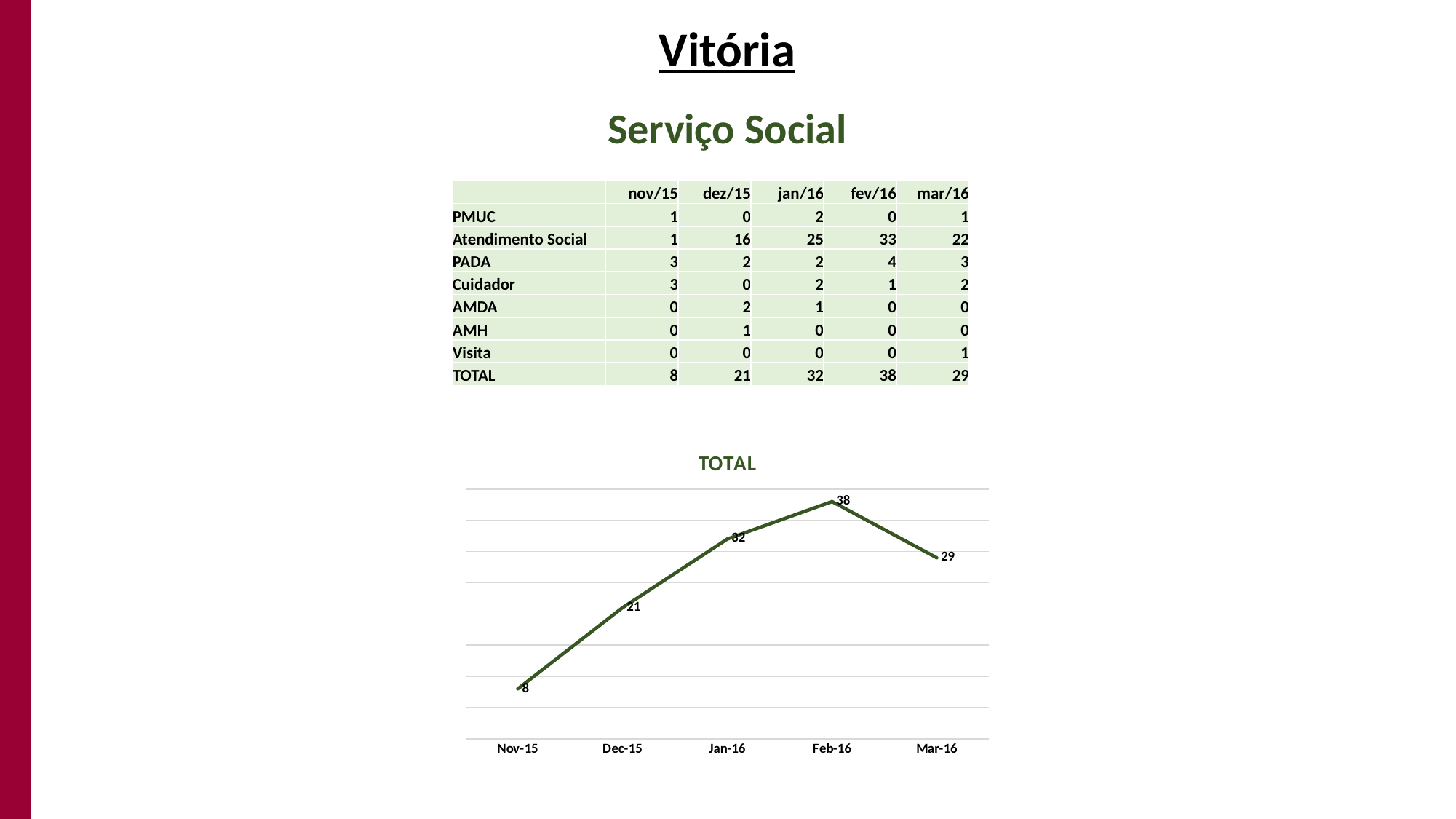
What kind of chart is the TOTAL chart? Line chart Which month has the highest value in the TOTAL chart? Feb-16 Does the value in the TOTAL chart rise or fall from Nov-15 to Feb-16? Rise Which is larger in the TOTAL chart, the value for Jan-16 or the value for Mar-16? Jan-16 Which month has the lowest value in the TOTAL chart? Nov-15 What is the difference between the Feb-16 and Mar-16 values in the TOTAL chart? 9 What is the value for Mar-16 in the TOTAL chart? 29 What is the difference between the Jan-16 and Dec-15 values in the TOTAL chart? 11 What is the value for Feb-16 in the TOTAL chart? 38 What is the title of the chart on the slide? TOTAL What is the value for Nov-15 in the TOTAL chart? 8 How many data points are plotted in the TOTAL chart? 5